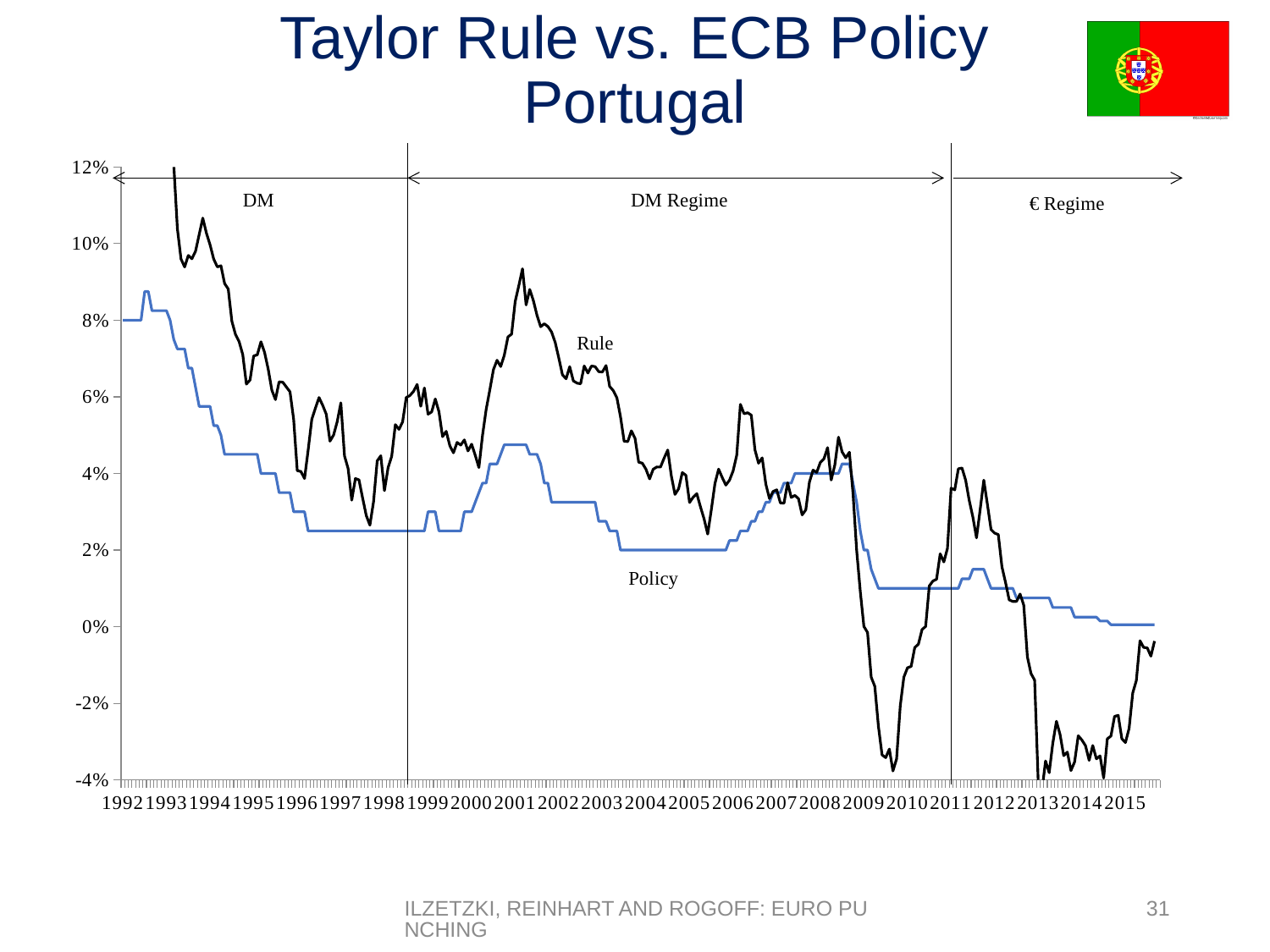
What kind of chart is shown on the slide? line chart What are the names of the two series plotted on the chart? Rule and Policy Is the Policy value in 2004 greater or less than 4%? less Is the Policy value in 2015 greater or less than 2%? less What is the title of the chart on the slide? Taylor Rule vs. ECB Policy Portugal In 2004, which series is higher, Rule or Policy? Rule Is the lowest Rule value in 2010 greater or less than 0%? less Does the Policy series overall rise or fall from 1992 to 2015? fall How many series are plotted on the chart? 2